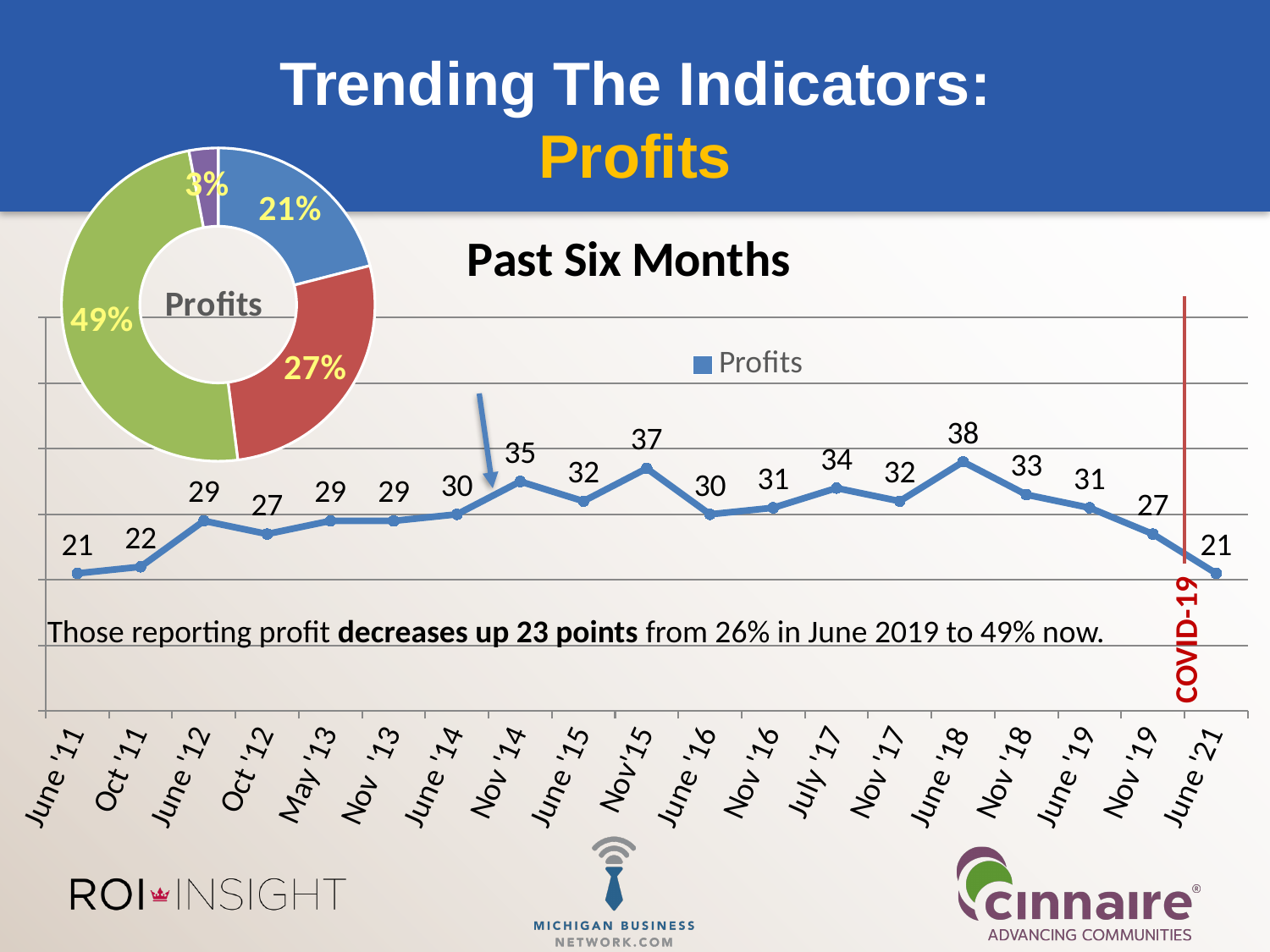
In the line chart titled Past Six Months, what is the value for June '18? 38 What kind of chart is the chart labelled Profits in the top left of the slide? doughnut chart In the line chart titled Past Six Months, how many series does the legend list? 1 In the doughnut chart labelled Profits, how many slices are there? 4 In the line chart titled Past Six Months, which is larger, the value for Nov '14 or the value for June '16? Nov '14 In the line chart titled Past Six Months, which date has the highest value? June '18 In the line chart titled Past Six Months, how many data points are plotted? 19 In the line chart titled Past Six Months, what is the value for June '21? 21 In the line chart titled Past Six Months, what is the difference between the values for June '18 and June '21? 17 In the line chart titled Past Six Months, do the values rise or fall from June '18 to June '21? fall In the line chart titled Past Six Months, what is the value for Nov '15? 37 In the doughnut chart labelled Profits, what is the largest slice's share? 49%